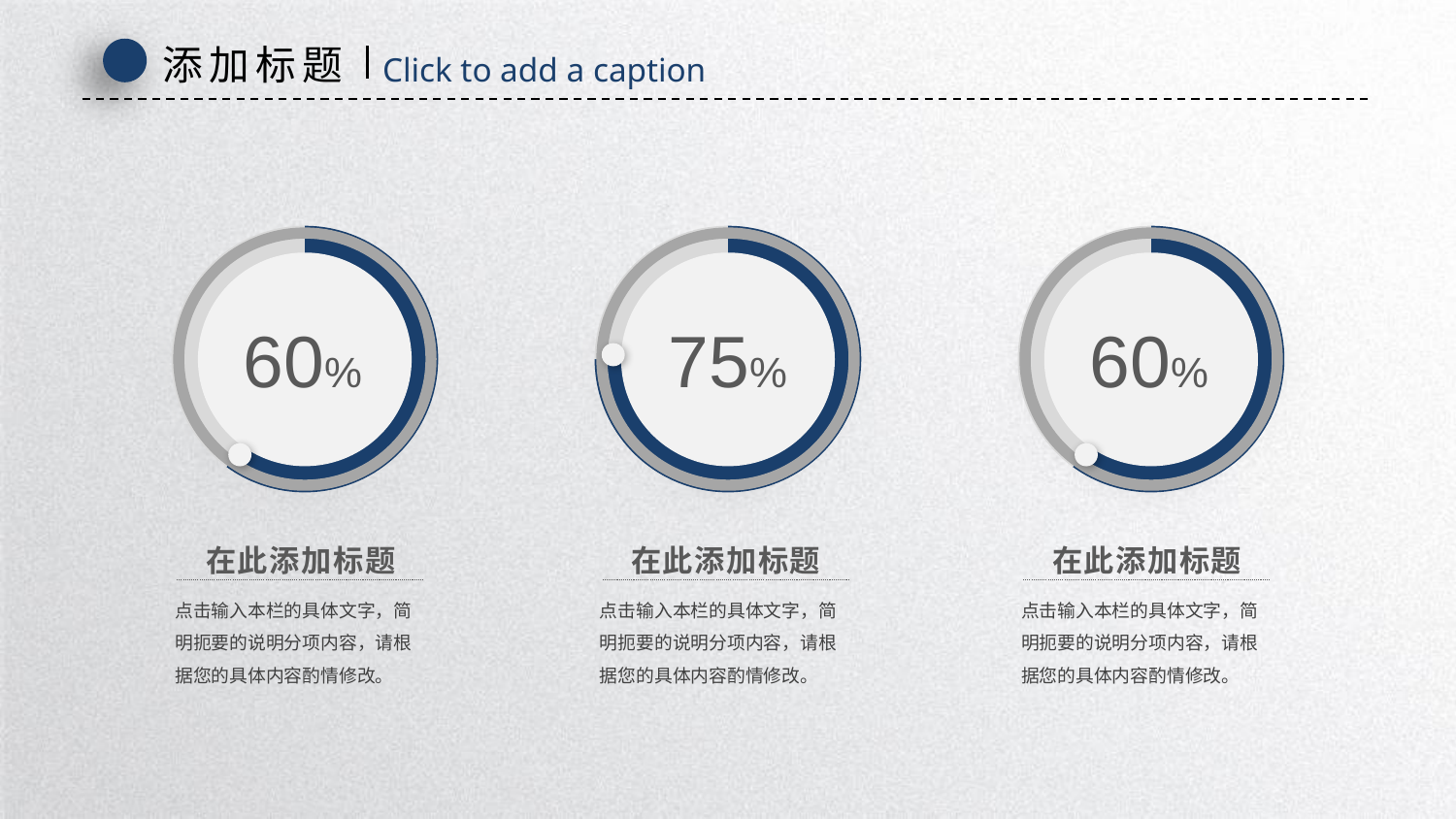
What is the difference between the middle chart's percentage and the right chart's percentage? 15 percentage points What percentage is shown in the right circular chart? 60% Is the percentage in the middle chart larger or smaller than the percentage in the left chart? Larger What colour is the filled portion of the ring in each chart? Dark blue What kind of chart is used to display the percentages on this slide? Doughnut (ring) chart Which of the three circular charts shows the highest percentage? The middle chart (75%) Do the left and right charts show the same percentage? Yes, both show 60% Is the value in the middle chart greater or less than 50%? greater What is the total of the percentages shown in the three charts? 195% How many circular progress charts are on the slide? 3 What percentage is shown in the middle circular chart? 75% What percentage is shown in the left circular chart? 60%